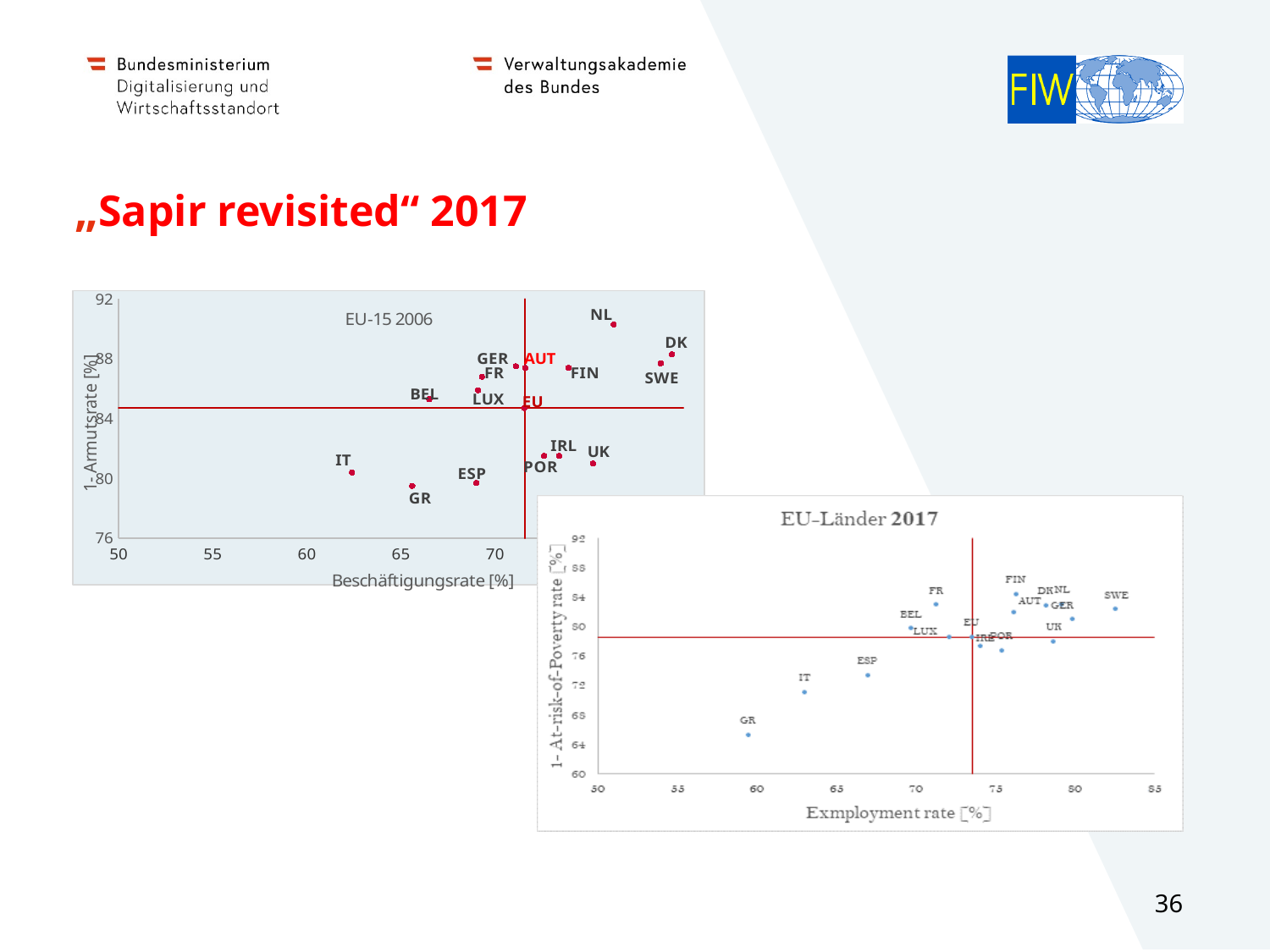
In the "EU-Länder 2017" chart, is the employment rate for GR greater or less than 60? less In the "EU-15 2006" chart, which has the higher 1-Armutsrate value, NL or IT? NL In the "EU-Länder 2017" chart, is the 1-At-risk-of-Poverty rate for IT greater or less than 72? less What kind of chart is the "EU-Länder 2017" chart? Scatter chart In the "EU-Länder 2017" chart, which has the higher employment rate, SWE or ESP? SWE In the "EU-15 2006" chart, which country has the lowest Beschäftigungsrate? IT In the "EU-15 2006" chart, which country has the highest 1-Armutsrate value? NL In the "EU-Länder 2017" chart, which country has the highest employment rate? SWE What kind of chart is the "EU-15 2006" chart? Scatter chart In the "EU-Länder 2017" chart, which country has the lowest 1-At-risk-of-Poverty rate? GR In the "EU-15 2006" chart, is the 1-Armutsrate value for GR greater or less than 80? less What is the x-axis label of the "EU-Länder 2017" chart? Employment rate [%]